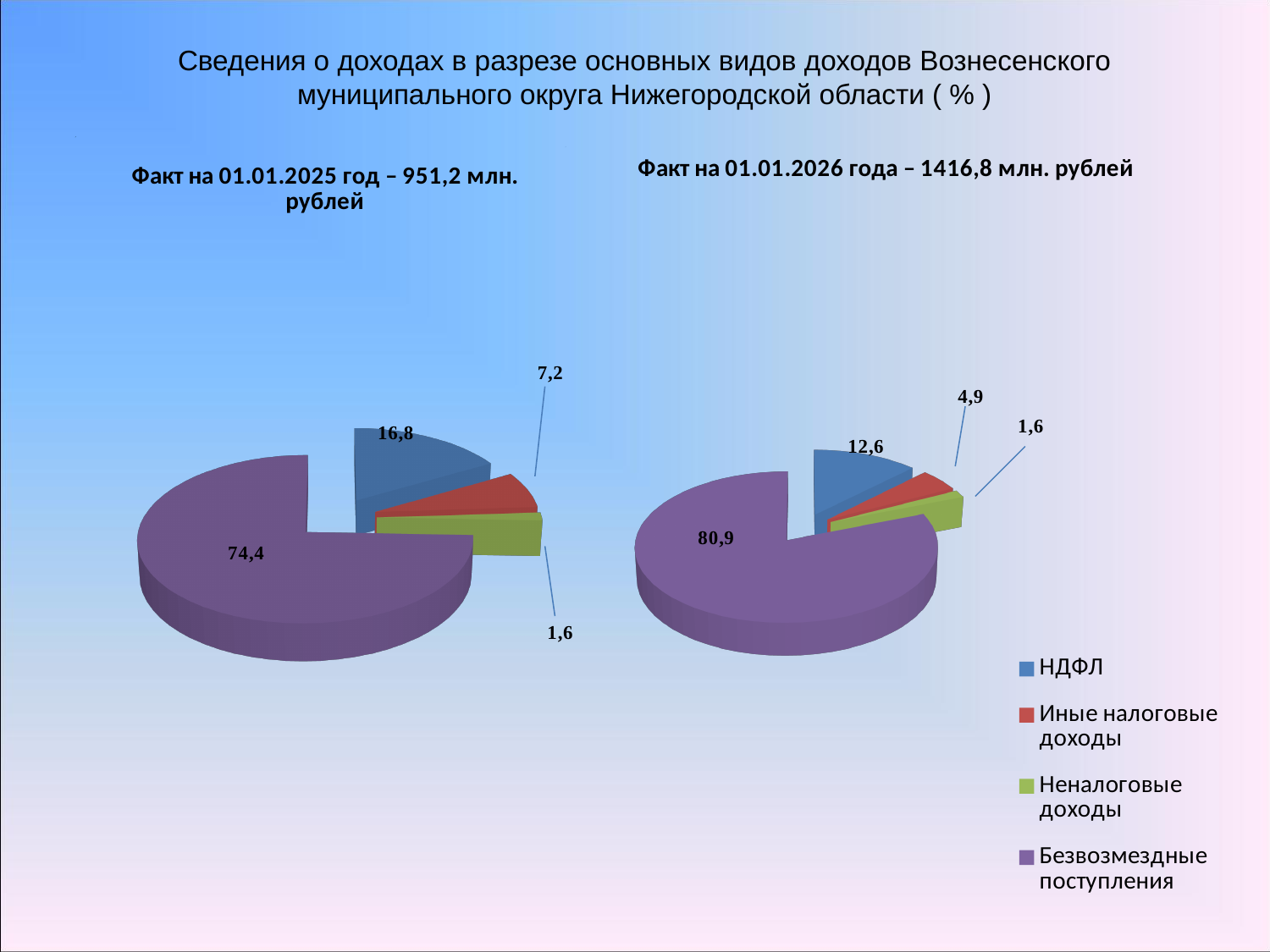
How many entries does the legend list? 4 In the left chart (Факт на 01.01.2025 год), what is the value for Безвозмездные поступления? 74,4 What colour represents Безвозмездные поступления in the charts? Purple In the right chart (Факт на 01.01.2026 года), what is the value for Неналоговые доходы? 1,6 How many slices does the right chart (Факт на 01.01.2026 года) have? 4 What type of chart is used on this slide? Pie chart In the left chart (Факт на 01.01.2025 год), what is the difference between НДФЛ and Иные налоговые доходы? 9,6 In the left chart (Факт на 01.01.2025 год), what is the value for Иные налоговые доходы? 7,2 In the left chart (Факт на 01.01.2025 год), which category has the smallest share? Неналоговые доходы In the right chart (Факт на 01.01.2026 года), which category has the largest share? Безвозмездные поступления In the right chart (Факт на 01.01.2026 года), what is the value for НДФЛ? 12,6 Which is larger: НДФЛ in the left chart (01.01.2025) or НДФЛ in the right chart (01.01.2026)? Left chart (01.01.2025), 16,8